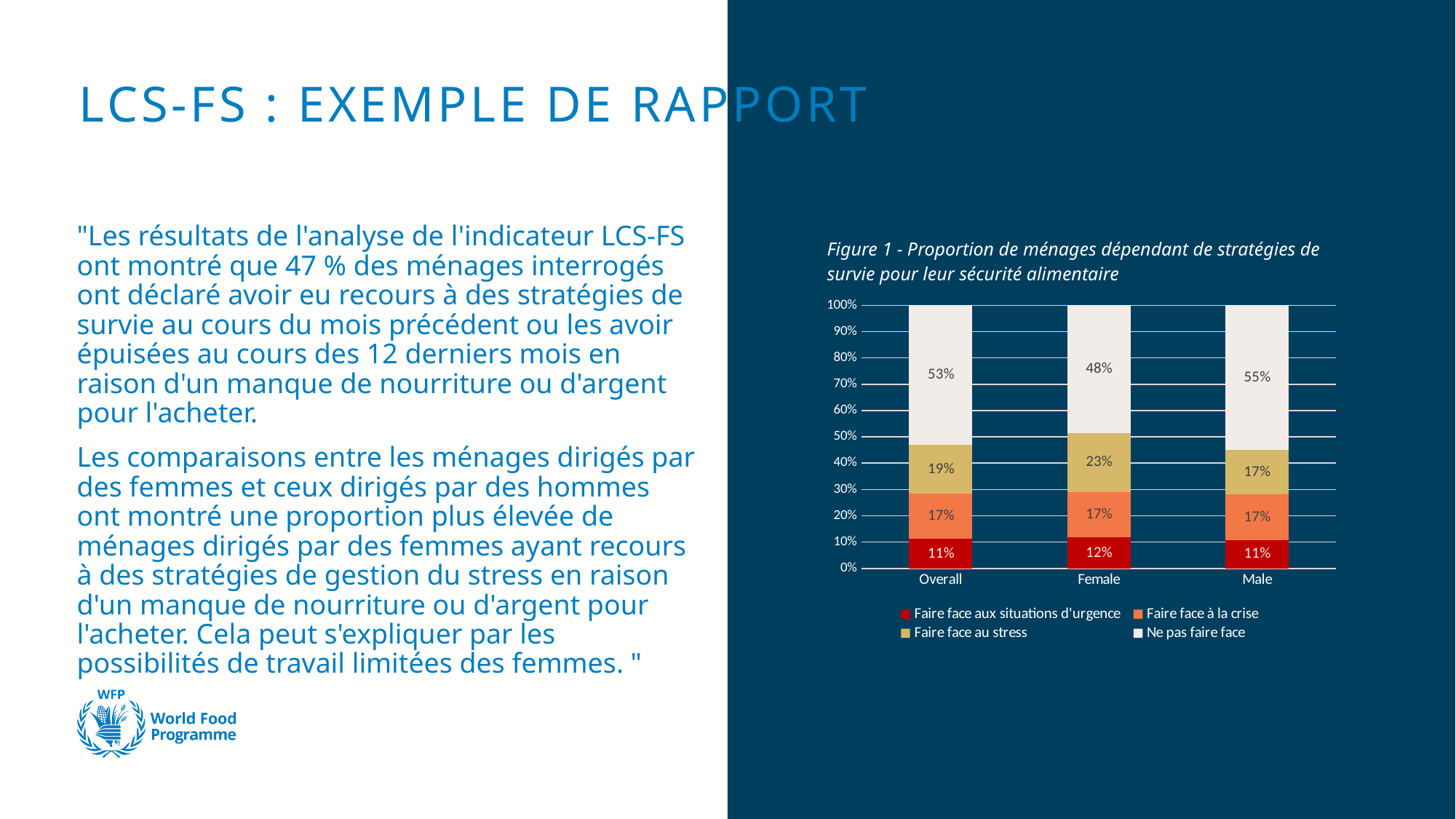
Which category has the highest value for 'Faire face au stress'? Female What is the value of 'Ne pas faire face' for the Female category? 48% What is the total of the 'Faire face aux situations d'urgence' and 'Faire face à la crise' segments for the Female bar? 29% What is the value of 'Faire face au stress' for the Male category? 17% How many categories are shown on the x axis? 3 What is the difference between the 'Ne pas faire face' values for Male and Female? 7% Which category has the lowest value for 'Ne pas faire face'? Female Which is larger: 'Faire face au stress' for Female or for Overall? Female What is the title of the figure? Figure 1 - Proportion de ménages dépendant de stratégies de survie pour leur sécurité alimentaire What kind of chart is shown on the slide? Stacked bar chart How many series does the legend list? 4 What is the value of 'Faire face aux situations d'urgence' for the Overall category? 11%